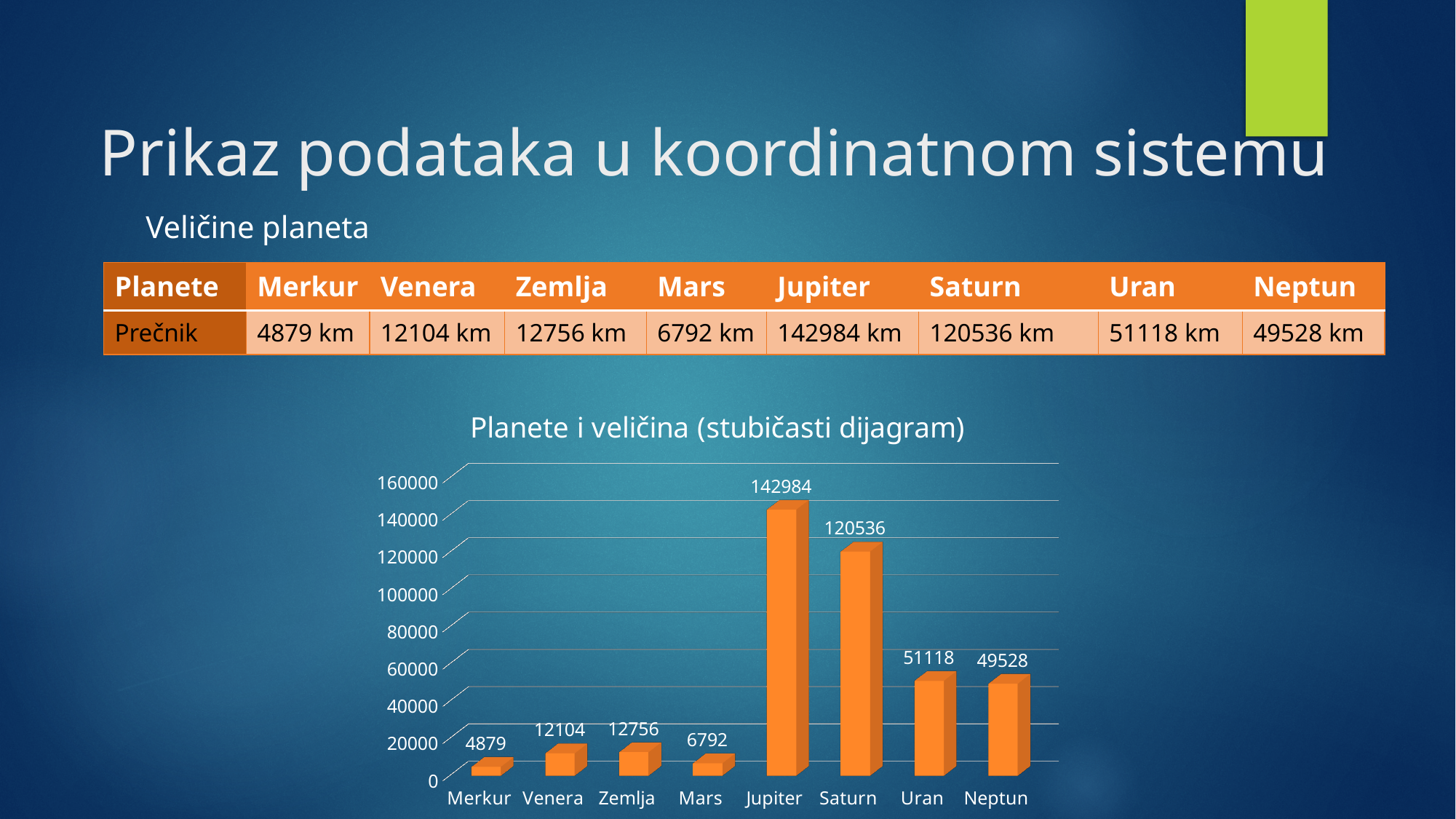
Which planet has the lowest value in the chart? Merkur What is the value shown for Jupiter in the chart? 142984 What is the value shown for Neptun in the chart? 49528 What is the difference between the values for Zemlja and Venera? 652 What kind of chart is shown on the slide? bar chart What is the value shown for Mars in the chart? 6792 Which has a larger value, Uran or Neptun? Uran Is the value for Saturn greater or less than 100000? greater What is the title of the chart? Planete i veličina (stubičasti dijagram) How many planets are plotted in the chart? 8 What is the difference between the values for Jupiter and Saturn? 22448 Which planet has the highest value in the chart? Jupiter